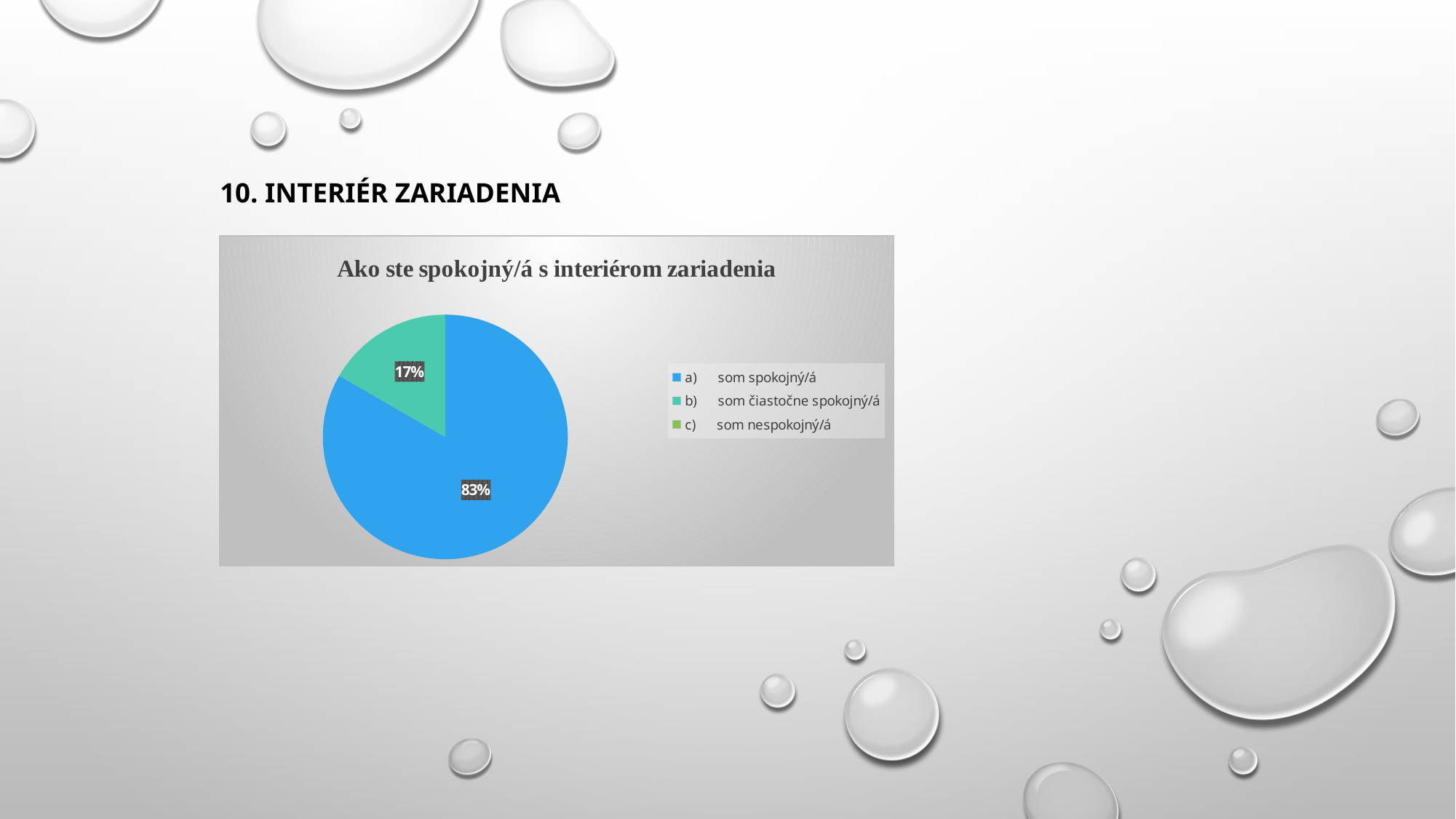
How many slices are visible in the pie? 2 What kind of chart is shown on the slide? pie chart How many entries does the legend list? 3 Which of the two labelled slices is larger, "a) som spokojný/á" or "b) som čiastočne spokojný/á"? a) som spokojný/á What share of the pie does the "b) som čiastočne spokojný/á" slice represent? 17% What percentage of the pie is labelled for "b) som čiastočne spokojný/á"? 17% What percentage of the pie is labelled for "a) som spokojný/á"? 83% What colour is the slice for "a) som spokojný/á"? blue What is the difference in percentage points between the "a) som spokojný/á" slice and the "b) som čiastočne spokojný/á" slice? 66 What is the title of the chart? Ako ste spokojný/á s interiérom zariadenia Which category has the largest share of the pie? a) som spokojný/á